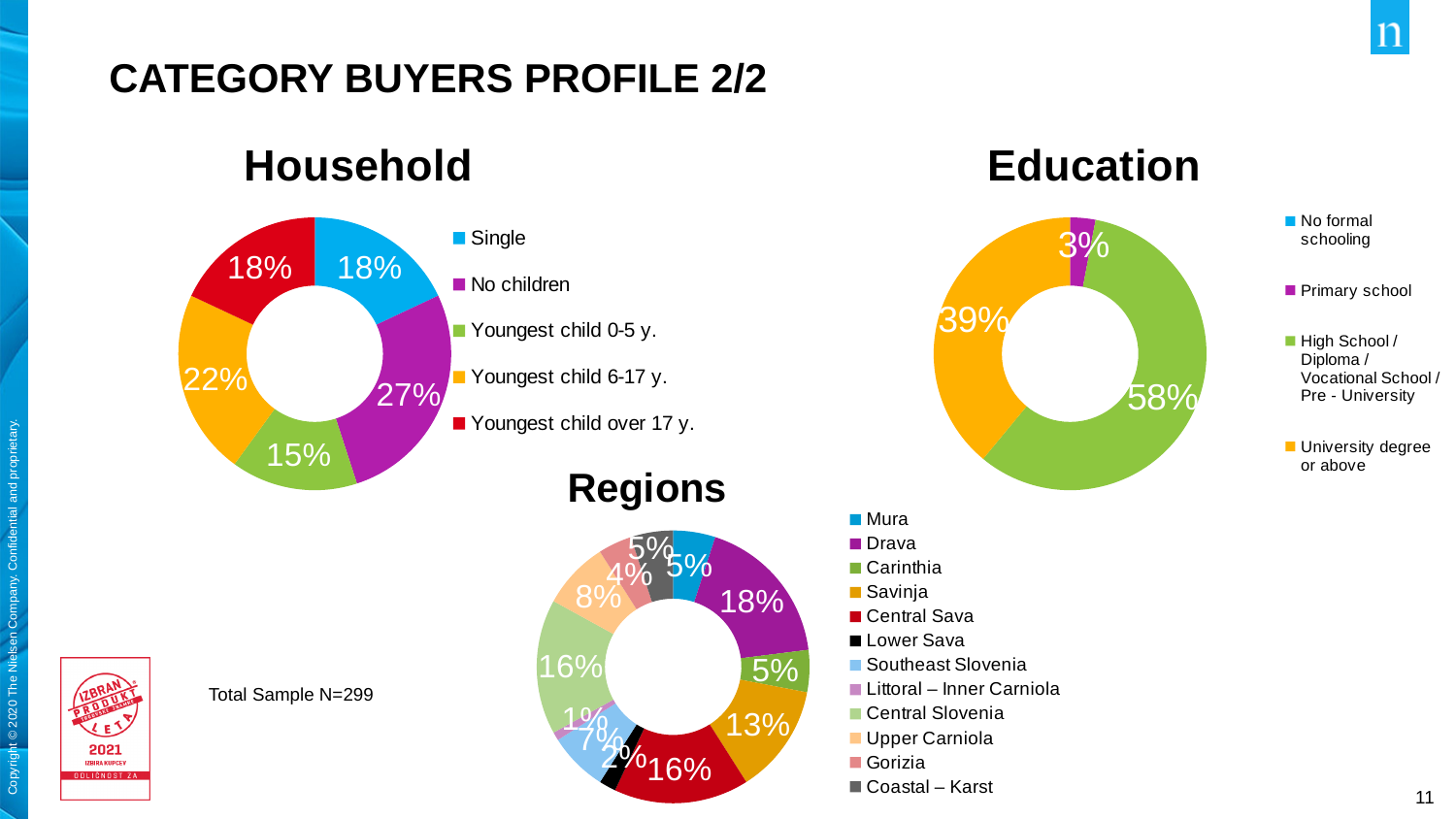
In the Education chart, what share of buyers have Primary school education? 3% In the Regions chart, what is the share for Drava? 18% In the Household chart, what is the difference between the share for Youngest child 6-17 y. and the share for Youngest child 0-5 y.? 7% In the Education chart, which education level has the largest share? High School / Diploma / Vocational School / Pre - University In the Household chart, which household type has the smallest share? Youngest child 0-5 y. How many entries does the legend of the Education chart list? 4 In the Regions chart, which has the larger share, Savinja or Upper Carniola? Savinja How many regions are listed in the legend of the Regions chart? 12 In the Household chart, which household type has the largest share? No children In the Household chart, what percentage of category buyers have no children? 27% In the Education chart, what share of buyers have High School / Diploma / Vocational School / Pre - University education? 58% In the Regions chart, which region has the largest share? Drava